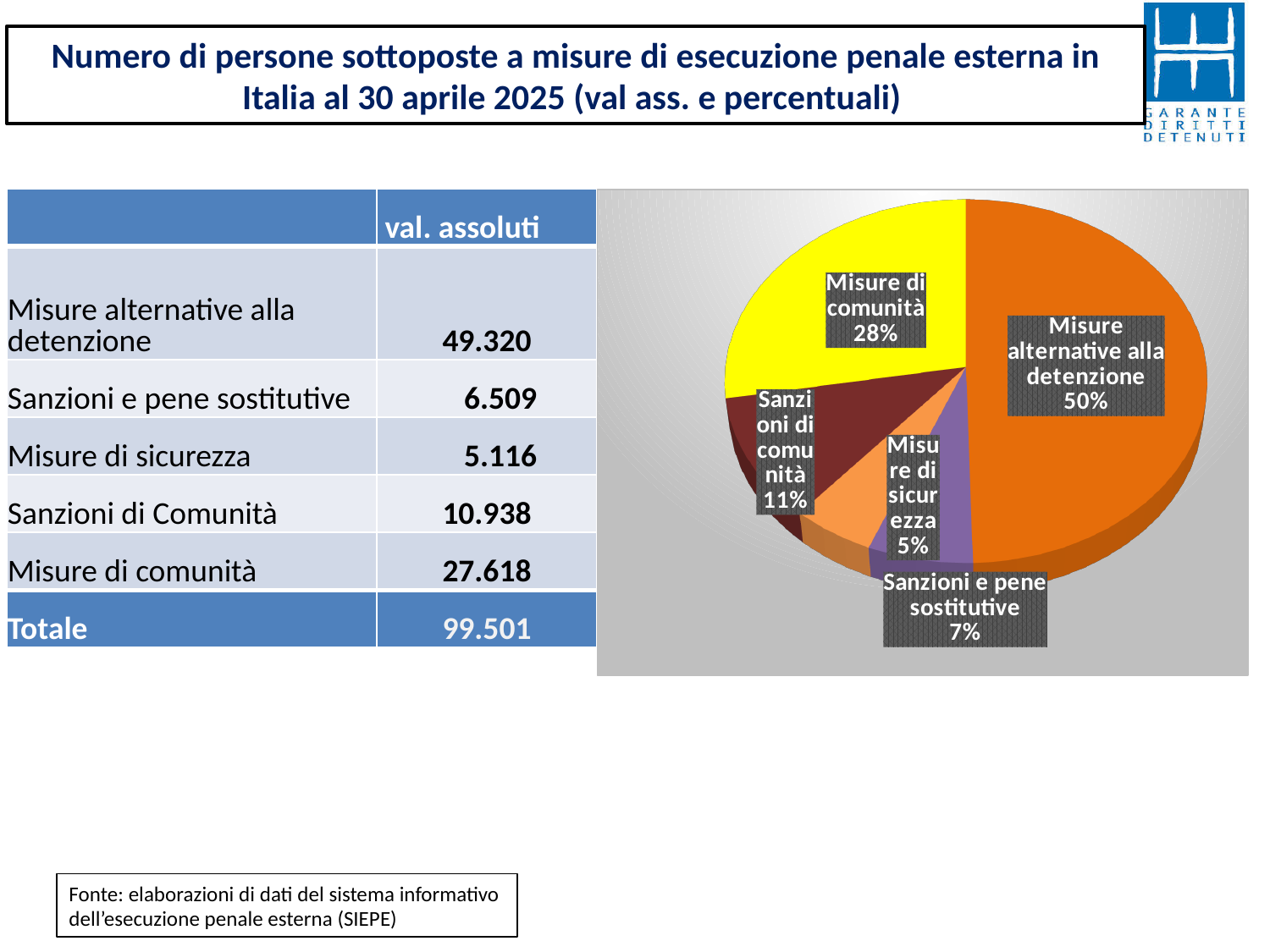
How many slices does the pie chart have? 5 Which slice of the pie chart is the smallest? Misure di sicurezza What share of the pie does 'Misure di sicurezza' represent? 5% What is the difference in percentage points between 'Misure alternative alla detenzione' and 'Misure di comunità'? 22 What kind of chart is shown on the slide? pie chart What share of the pie does 'Misure alternative alla detenzione' represent? 50% What colour is the 'Misure di comunità' slice in the pie chart? yellow What share of the pie does 'Sanzioni e pene sostitutive' represent? 7% Which slice of the pie chart is the largest? Misure alternative alla detenzione Which is larger in the pie chart: 'Sanzioni di comunità' or 'Sanzioni e pene sostitutive'? Sanzioni di comunità